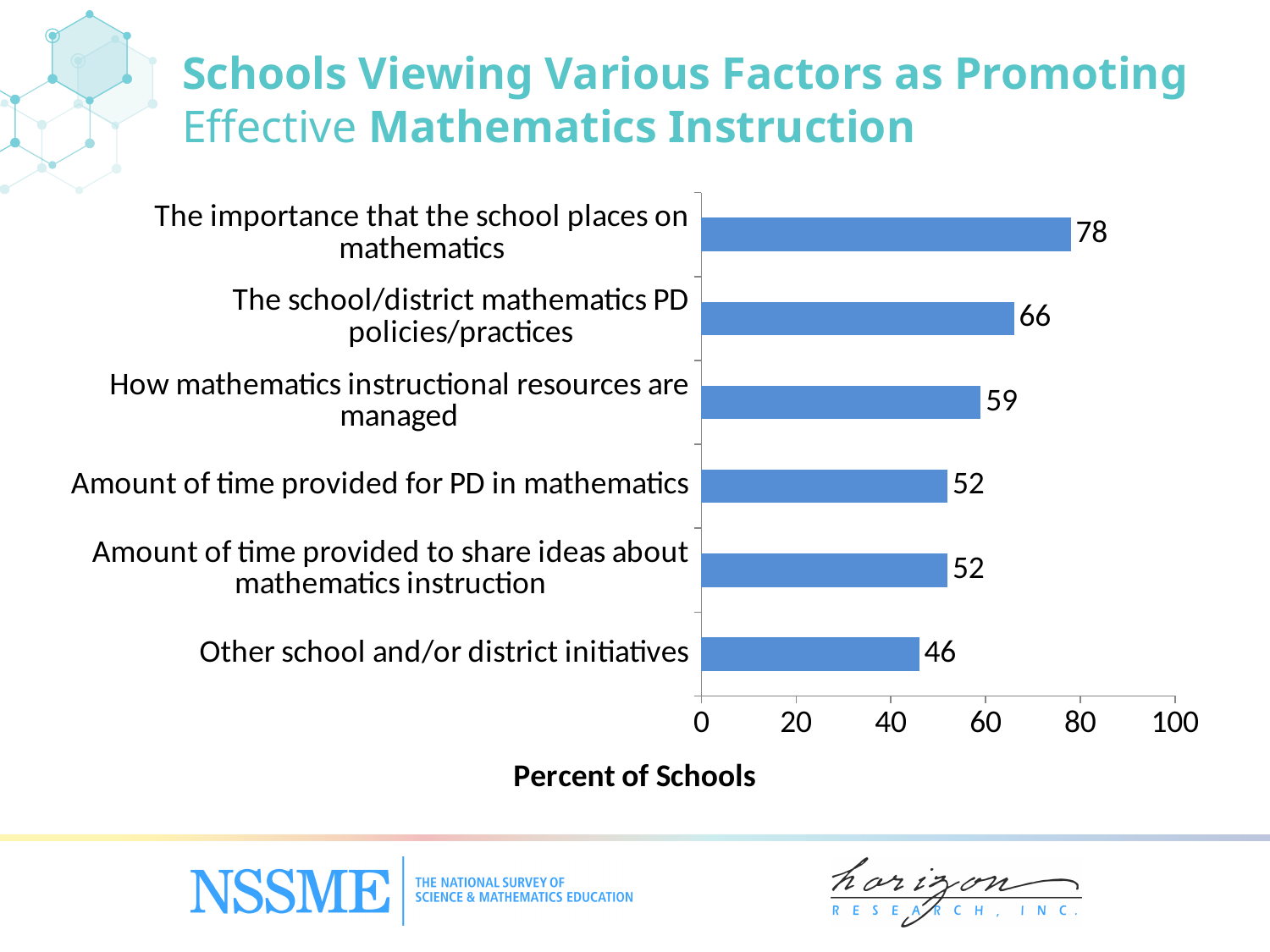
What is the label of the horizontal axis? Percent of Schools Which factor has the lowest percent of schools? Other school and/or district initiatives What is the difference between the values for 'The importance that the school places on mathematics' and 'Other school and/or district initiatives'? 32 Which is larger: the value for 'How mathematics instructional resources are managed' or the value for 'Amount of time provided for PD in mathematics'? How mathematics instructional resources are managed What is the difference between the values for 'The school/district mathematics PD policies/practices' and 'How mathematics instructional resources are managed'? 7 What percent of schools view the importance that the school places on mathematics as promoting effective mathematics instruction? 78 Which factor has the highest percent of schools? The importance that the school places on mathematics What is the value for 'Other school and/or district initiatives'? 46 How many factors are shown in the chart? 6 Is the value for 'Other school and/or district initiatives' greater or less than 60? less What is the value for 'The school/district mathematics PD policies/practices'? 66 What kind of chart is shown on the slide? bar chart